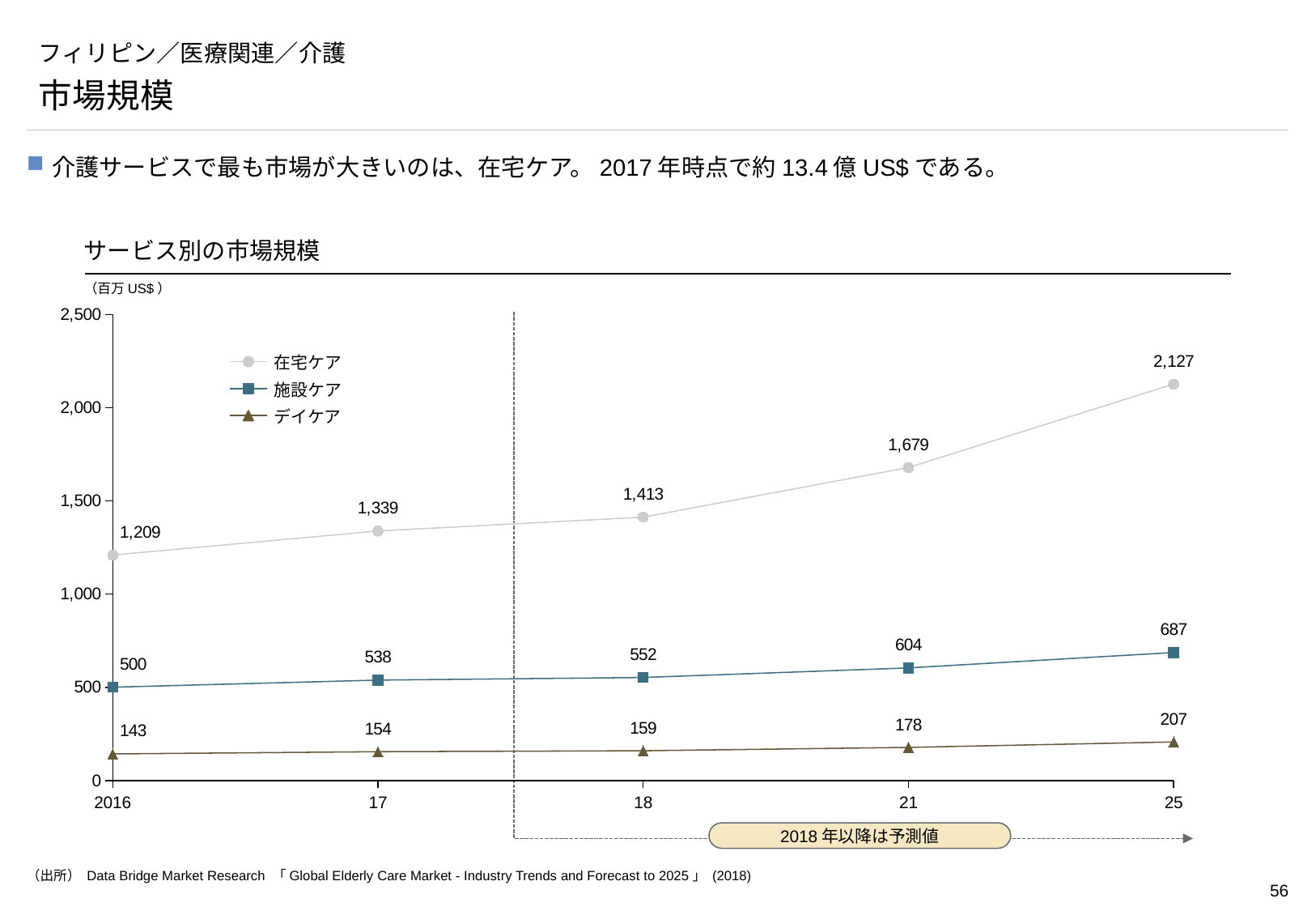
How many years are plotted on the x axis? 5 What is the value for 施設ケア in 2021? 604 What kind of chart is shown? line chart Does the 施設ケア series rise or fall from 2016 to 2025? rise Which series has the lowest value in 2016? デイケア Which series has the highest value in 2025? 在宅ケア How many series does the legend list? 3 Which is larger: 施設ケア in 2018 or デイケア in 2018? 施設ケア in 2018 What is the value for デイケア in 2025? 207 What is the value for 在宅ケア in 2017? 1,339 What is the difference between the 在宅ケア values in 2025 and 2016? 918 Is the value for 在宅ケア in 2021 greater or less than 1,500? greater